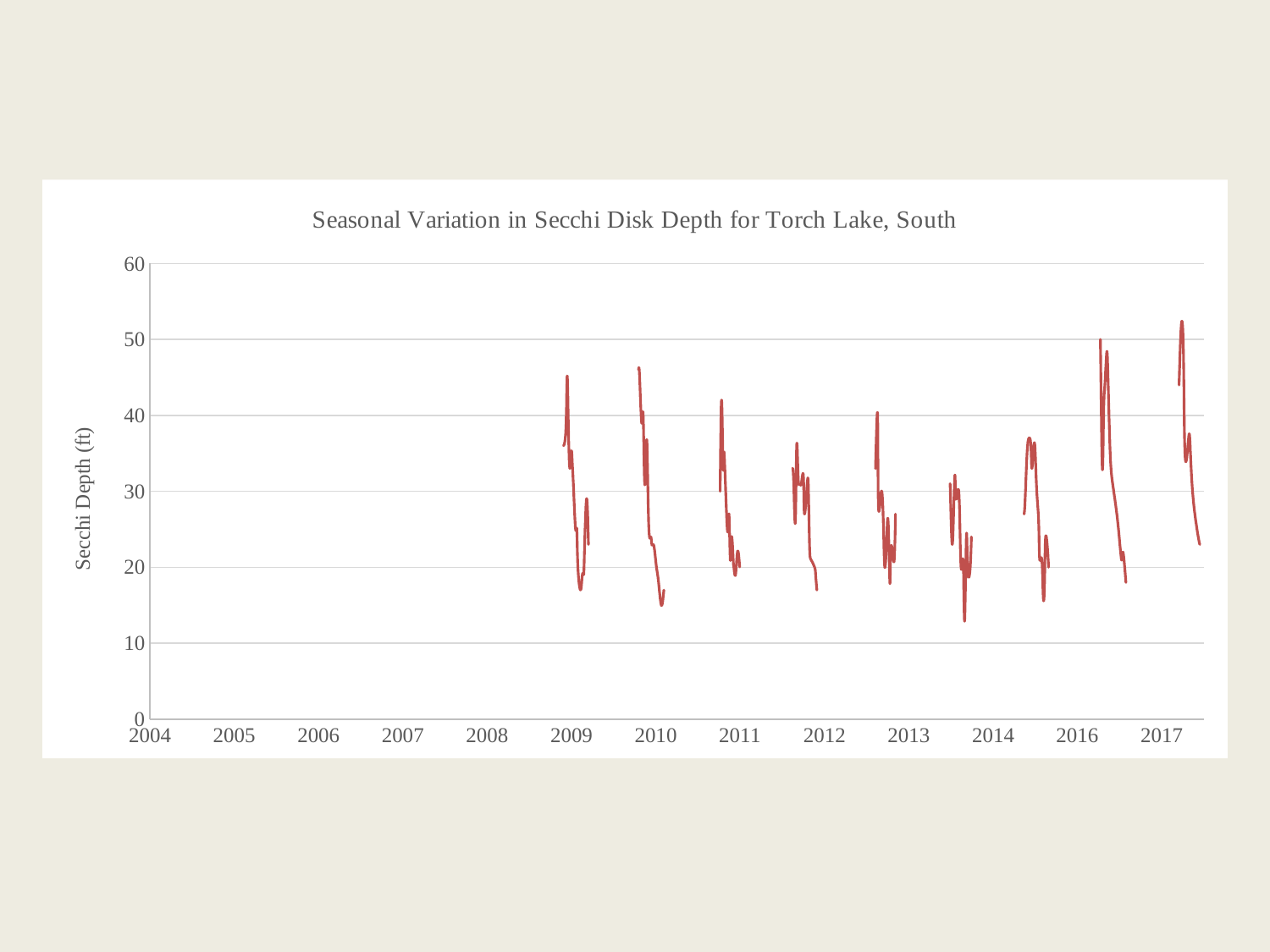
Is the highest Secchi depth recorded in the 2012 segment greater or less than 40? less Is the highest Secchi depth recorded in the 2017 segment greater or less than 50? greater Is the highest Secchi depth recorded in the 2009 segment greater or less than 40? greater What is the label on the vertical axis of the chart? Secchi Depth (ft) What kind of chart is shown on the slide? line chart What is the title of the chart? Seasonal Variation in Secchi Disk Depth for Torch Lake, South Within each yearly segment, does the Secchi depth generally rise or fall as the season progresses along the x axis? fall